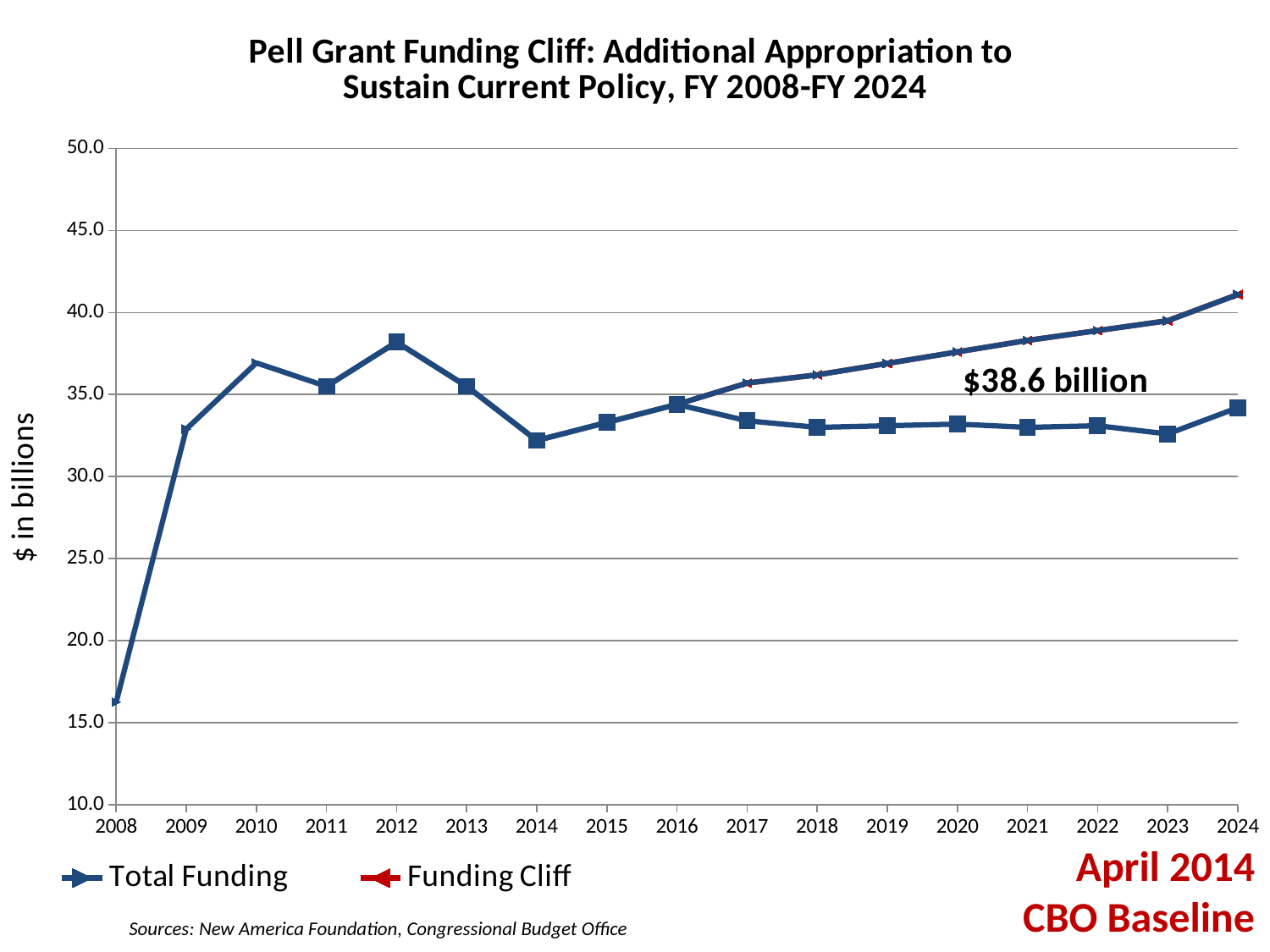
What is the label on the y axis? $ in billions Is the Total Funding value for 2008 greater or less than 20.0? less In which year does Total Funding reach its highest value? 2012 In which year is Total Funding at its lowest? 2008 How many series does the legend list? 2 How many years are plotted along the x axis? 17 Which is larger, Total Funding in 2012 or Total Funding in 2014? 2012 Is the Funding Cliff value for 2024 greater or less than 40.0? greater In which year is the Funding Cliff series at its highest? 2024 Does the Funding Cliff series rise or fall from 2017 to 2024? rise Is the Total Funding value for 2012 greater or less than 35.0? greater What kind of chart is shown on the slide? line chart